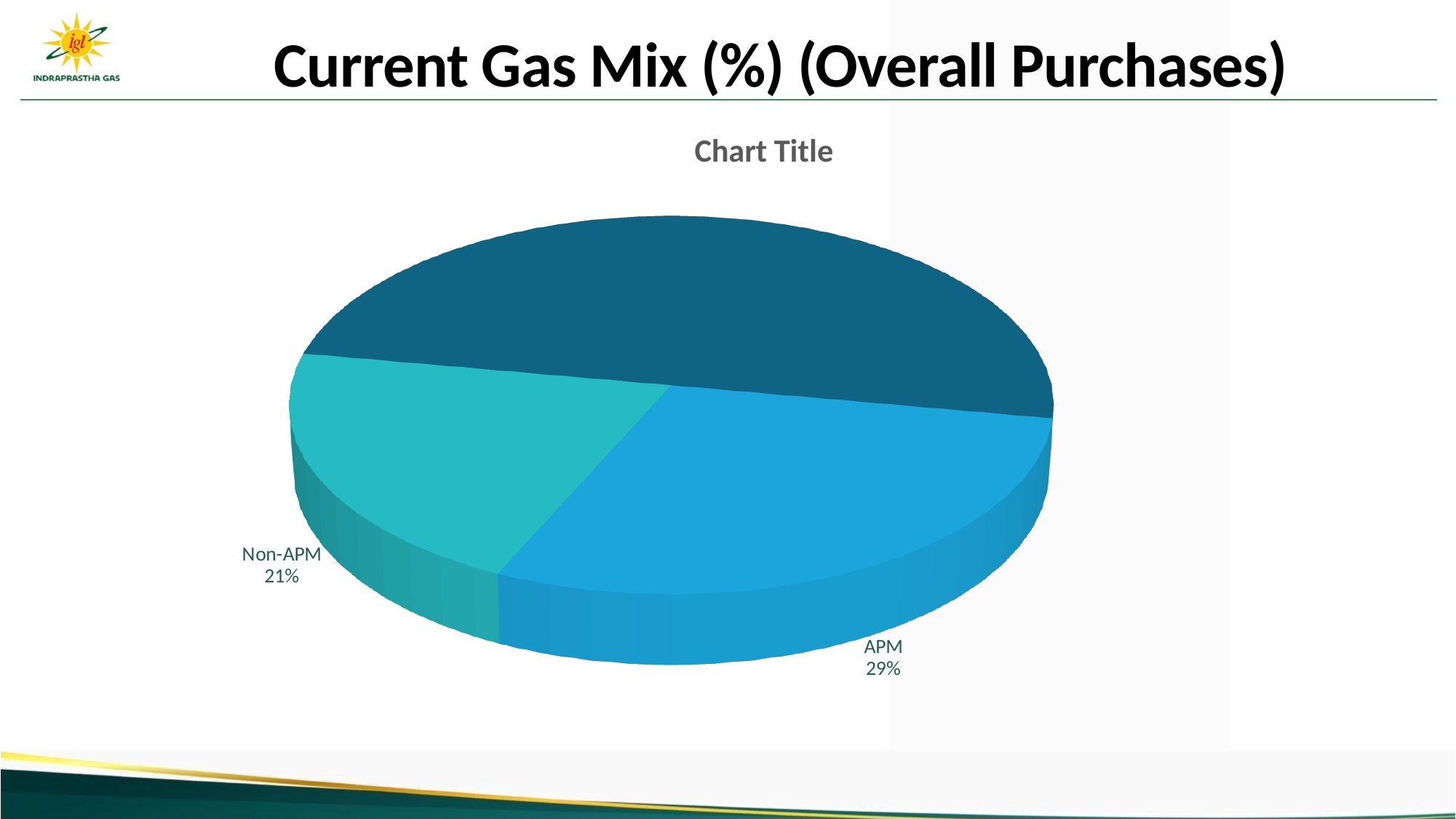
Which slice is larger, APM or Non-APM? APM What is the title printed above the pie chart? Chart Title Is the share for Non-APM greater or less than 25%? less What percentage share does Non-APM have in the pie chart? 21% What kind of chart is shown on the slide? Pie chart What is the title of the slide? Current Gas Mix (%) (Overall Purchases) How many slices does the pie chart have? 3 What is the difference in percentage points between the APM and Non-APM shares? 8 percentage points What percentage share does APM have in the pie chart? 29% Which labelled category has the smallest share of the pie? Non-APM